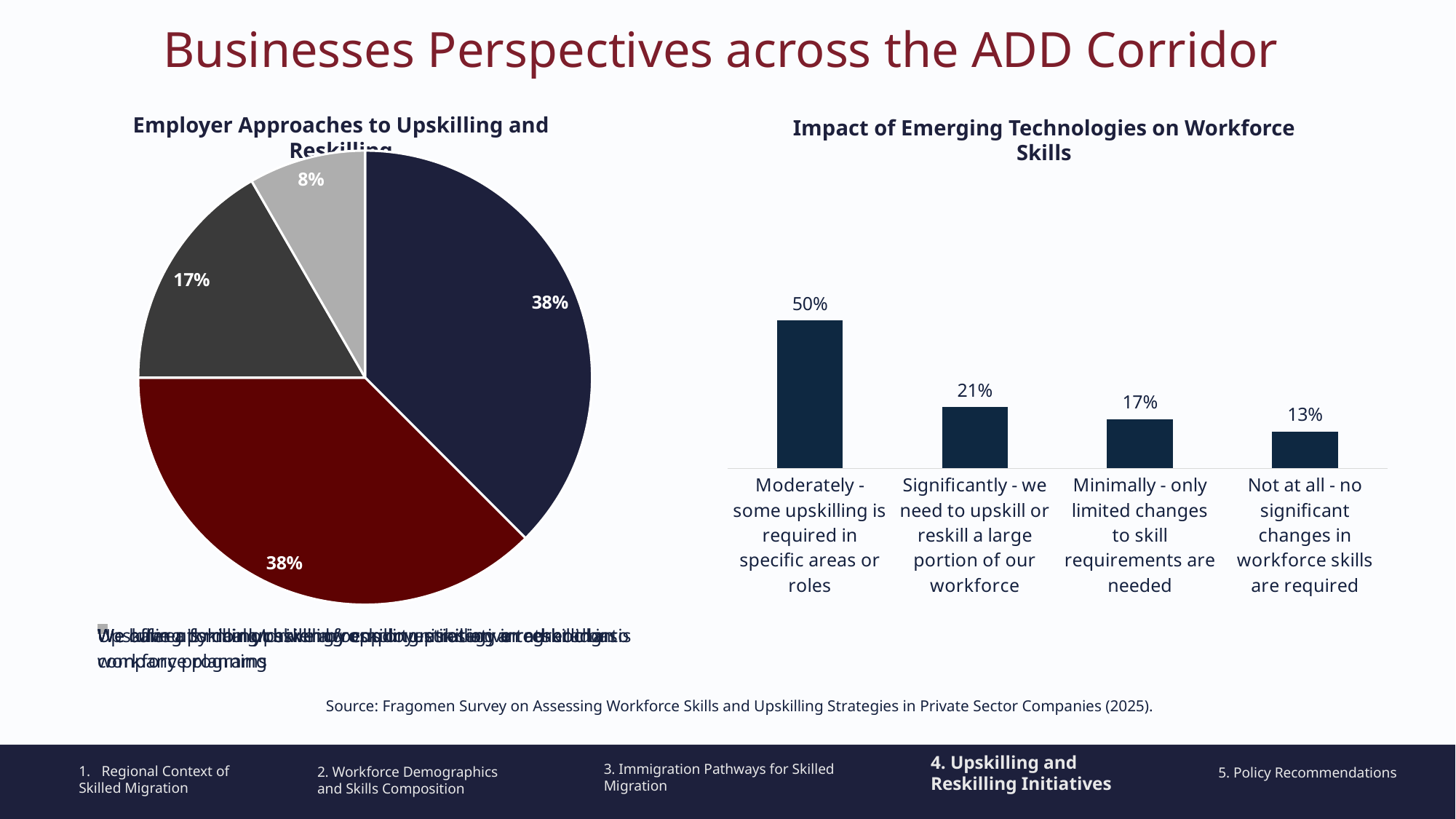
In the 'Impact of Emerging Technologies on Workforce Skills' chart, which category has the highest value? Moderately - some upskilling is required in specific areas or roles What kind of chart is 'Employer Approaches to Upskilling and Reskilling'? Pie chart How many slices does the 'Employer Approaches to Upskilling and Reskilling' pie chart have? 4 In the 'Impact of Emerging Technologies on Workforce Skills' chart, what percentage is shown for 'Moderately - some upskilling is required in specific areas or roles'? 50% How many categories are shown in the 'Impact of Emerging Technologies on Workforce Skills' chart? 4 In the 'Impact of Emerging Technologies on Workforce Skills' chart, do the values rise or fall from left to right? Fall In the 'Impact of Emerging Technologies on Workforce Skills' chart, which is larger: the value for 'Minimally' or the value for 'Not at all'? Minimally - only limited changes to skill requirements are needed In the 'Impact of Emerging Technologies on Workforce Skills' chart, what percentage is shown for 'Not at all - no significant changes in workforce skills are required'? 13% In the 'Impact of Emerging Technologies on Workforce Skills' chart, which category has the lowest value? Not at all - no significant changes in workforce skills are required In the 'Impact of Emerging Technologies on Workforce Skills' chart, what percentage is shown for 'Significantly - we need to upskill or reskill a large portion of our workforce'? 21% In the 'Impact of Emerging Technologies on Workforce Skills' chart, what is the difference between the 'Moderately' and 'Significantly' values? 29% What kind of chart is 'Impact of Emerging Technologies on Workforce Skills'? Bar chart